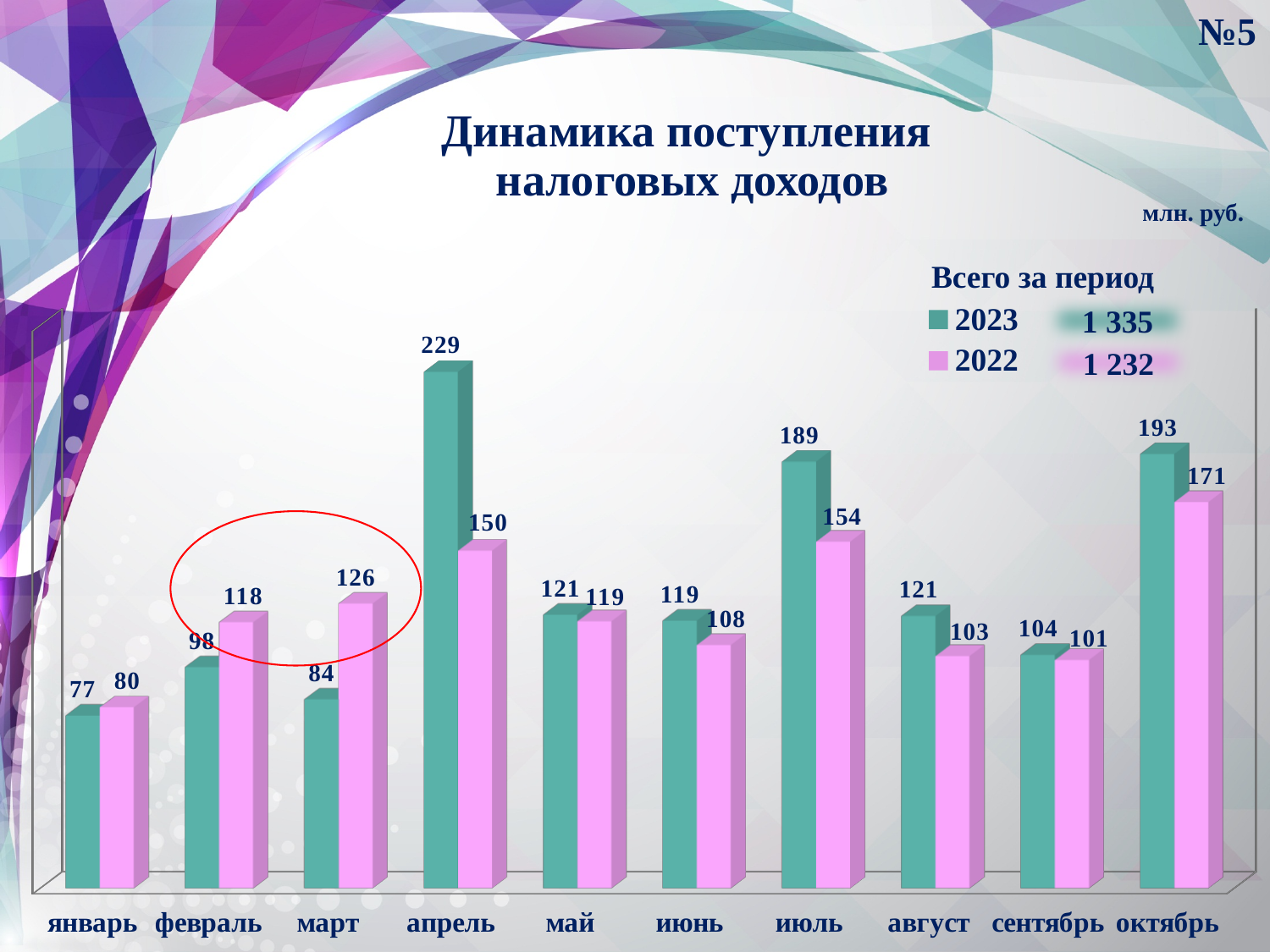
Which month has the highest value for the 2023 series? апрель What unit is indicated for the chart values? млн. руб. Which is larger in февраль: the 2023 value or the 2022 value? 2022 How many series does the legend list? 2 What is the value for 2023 in апрель? 229 What kind of chart is shown on the slide? bar chart What is the value for 2023 in сентябрь? 104 What is the value for 2022 in март? 126 What is the difference between the 2023 and 2022 values in июль? 35 What is the total for the 2023 series shown under 'Всего за период'? 1 335 Which month has the lowest value for the 2022 series? январь How many months are shown on the x axis? 10